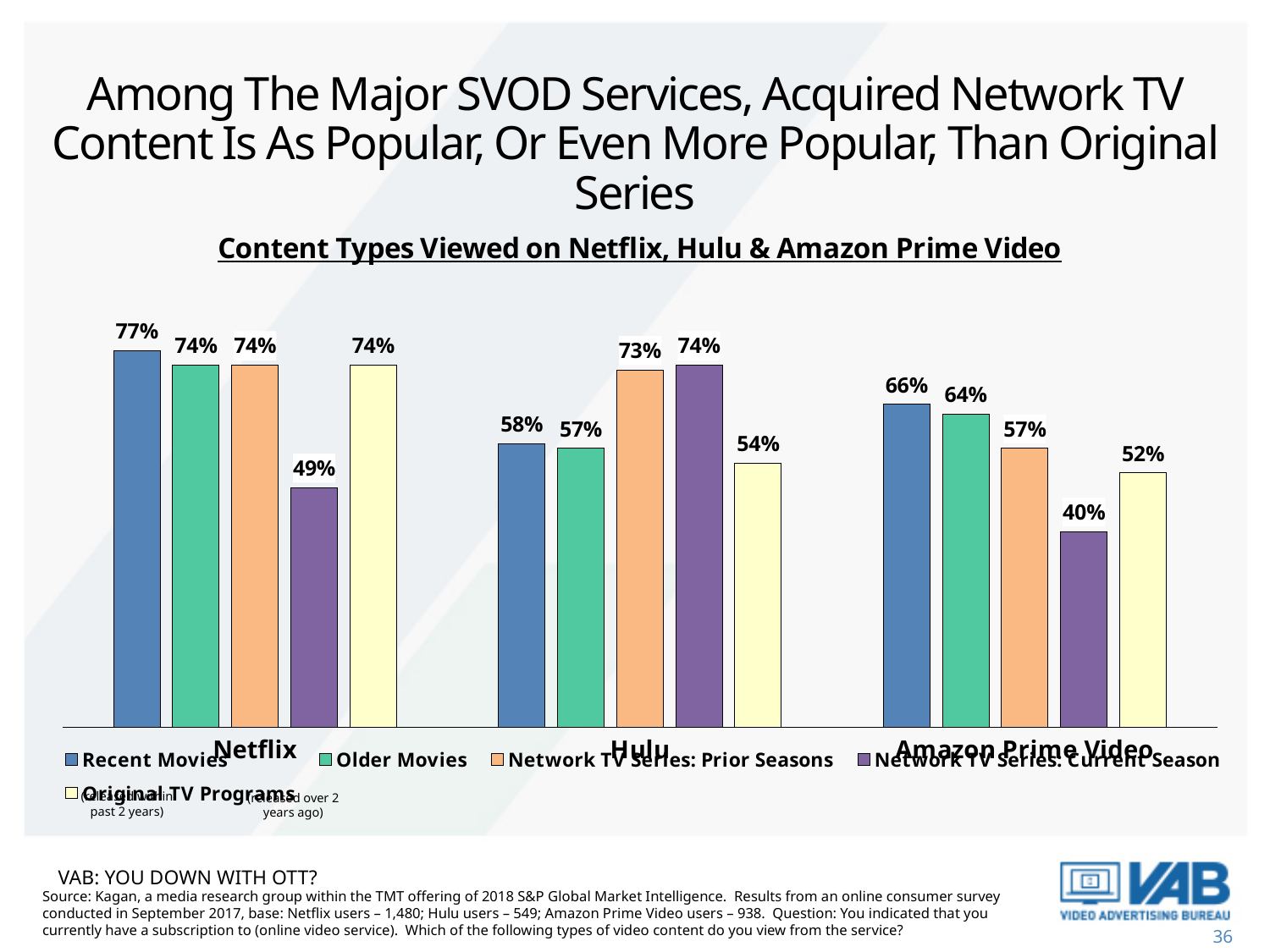
What is the title of the chart? Content Types Viewed on Netflix, Hulu & Amazon Prime Video What percentage of Amazon Prime Video users view Original TV Programs? 52% How many SVOD services are shown on the x axis? 3 Which is larger for Hulu: Network TV Series: Prior Seasons or Older Movies? Network TV Series: Prior Seasons What kind of chart is shown on the slide? Bar chart What percentage of Hulu users view Network TV Series: Current Season? 74% What is the difference between the Netflix and Hulu values for Recent Movies? 19% Which content type has the lowest value for Amazon Prime Video? Network TV Series: Current Season What is the difference between Older Movies and Network TV Series: Current Season for Amazon Prime Video? 24% Which content type has the highest value for Netflix? Recent Movies How many series does the legend list? 5 What percentage of Netflix users view Recent Movies? 77%